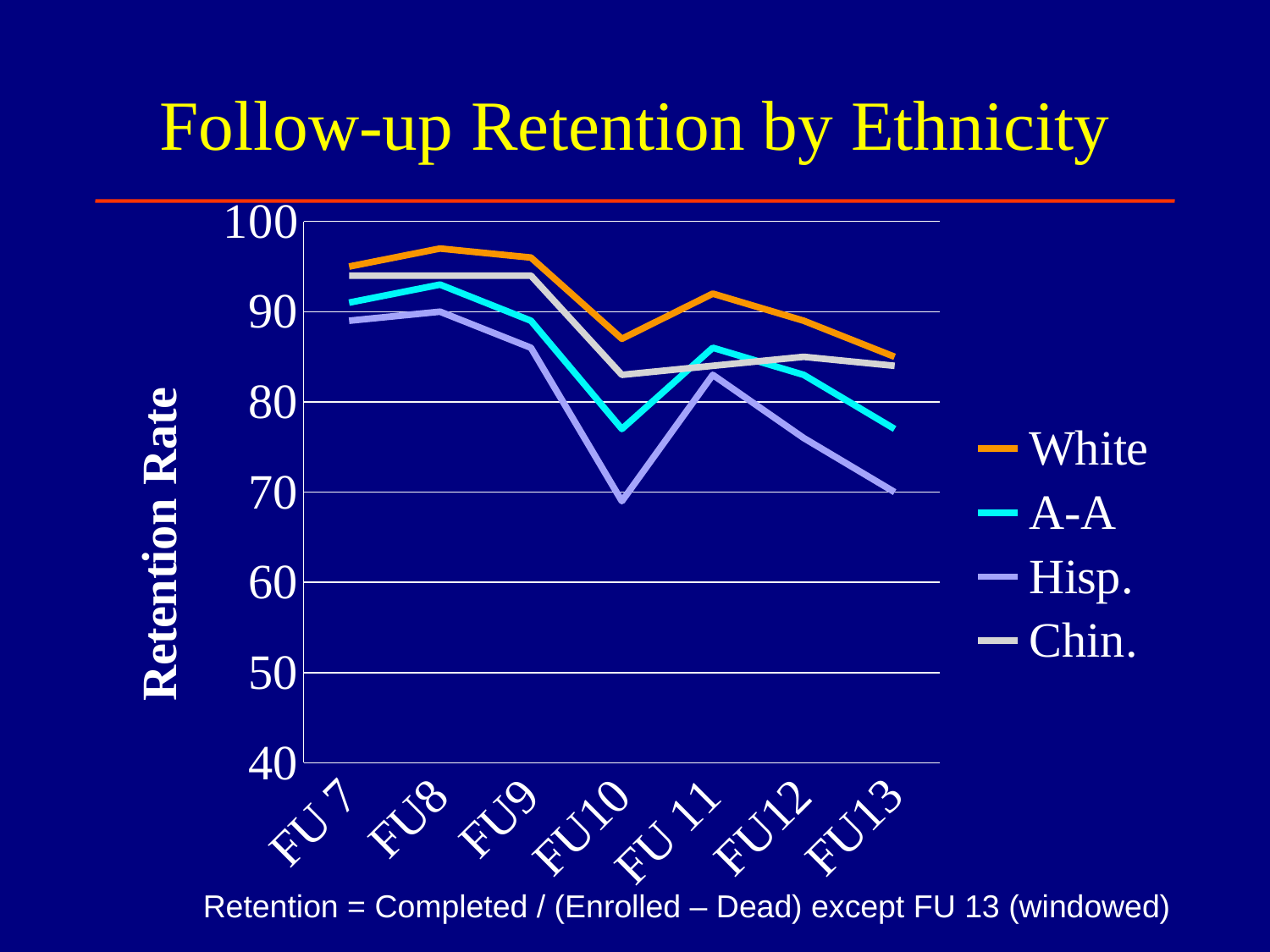
At which follow-up does the Hisp. line reach its lowest value? FU10 How many series does the legend list? 4 Which ethnicity has the lowest retention rate at FU10? Hisp. Is the retention rate for White at FU8 greater or less than 90? greater At FU13, which is larger, the retention rate for White or for Hisp.? White Does the White retention rate rise or fall from FU9 to FU10? fall What is the label on the y axis? Retention Rate Is the retention rate for A-A at FU10 greater or less than 80? less Is the retention rate for Hisp. at FU13 greater or less than 80? less What kind of chart is shown on the slide? line chart Which ethnicity has the highest retention rate at FU10? White How many follow-up points are shown along the x axis? 7